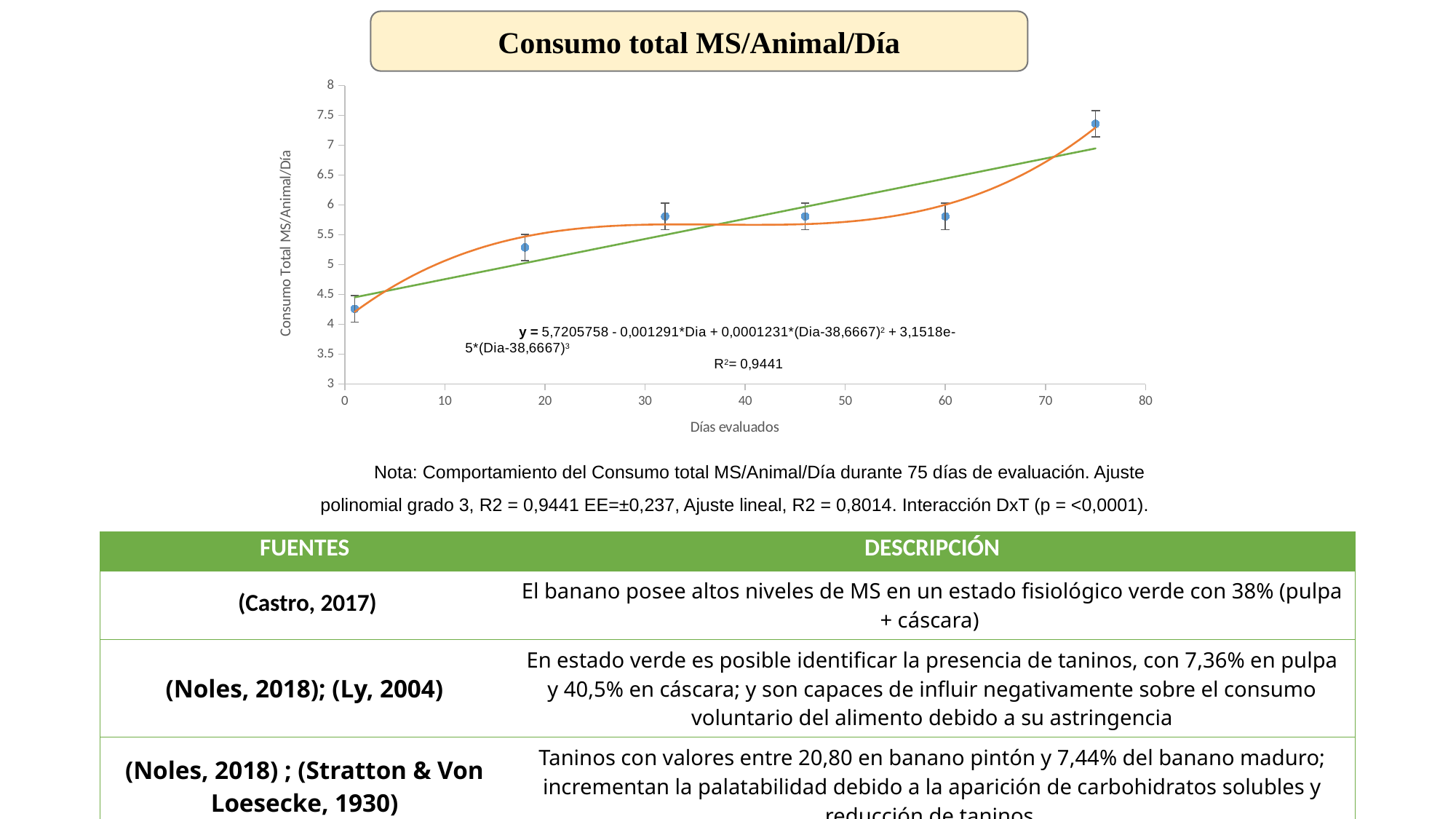
At which evaluated day is the plotted consumption lowest? 1 Which has the larger plotted value, day 18 or day 60? Day 60 Is the value at day 18 greater or less than 5? greater What kind of chart is shown on the slide? Scatter chart with trend lines Is the value at day 1 greater or less than 4.5? less What R² value is printed on the chart? 0,9441 At which evaluated day is the plotted consumption highest? 75 Is the value at day 75 greater or less than 7? greater How many data points are plotted on the chart? 6 Do the plotted values generally rise or fall as the evaluated days increase? Rise What is the title of the chart? Consumo total MS/Animal/Día